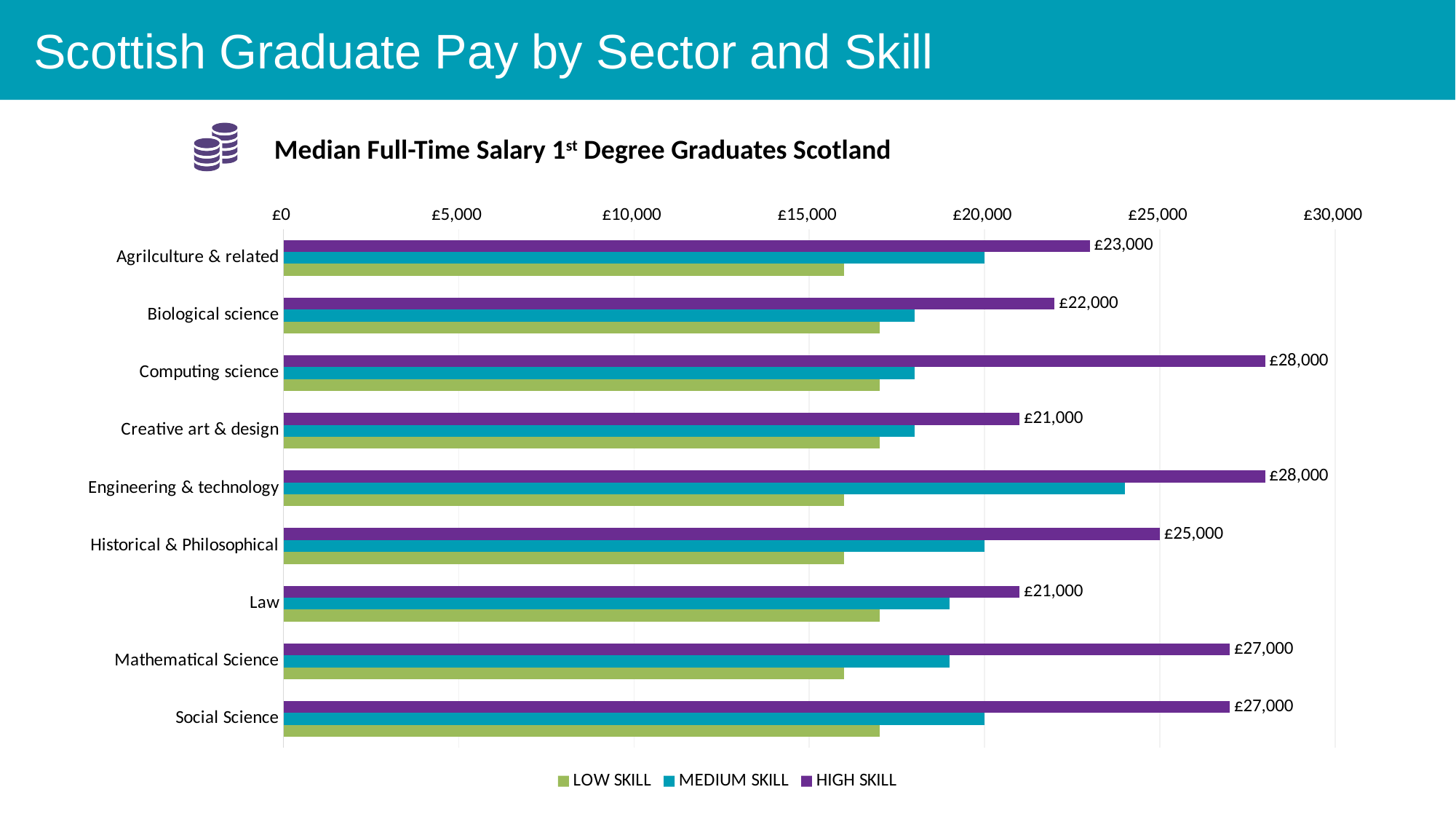
What kind of chart is shown on the slide? Bar chart How many series does the legend list? 3 Is the MEDIUM SKILL value for Engineering & technology greater or less than £20,000? greater What is the HIGH SKILL median salary for Computing science? £28,000 Is the LOW SKILL value for Agrilculture & related greater or less than £20,000? less Which has the larger HIGH SKILL salary, Historical & Philosophical or Mathematical Science? Mathematical Science How many sectors are shown on the chart? 9 What is the HIGH SKILL median salary for Historical & Philosophical? £25,000 Which sector has the highest MEDIUM SKILL median salary? Engineering & technology What is the difference between the HIGH SKILL salaries for Computing science and Biological science? £6,000 Which colour represents HIGH SKILL in the legend? Purple What is the HIGH SKILL median salary for Agrilculture & related? £23,000